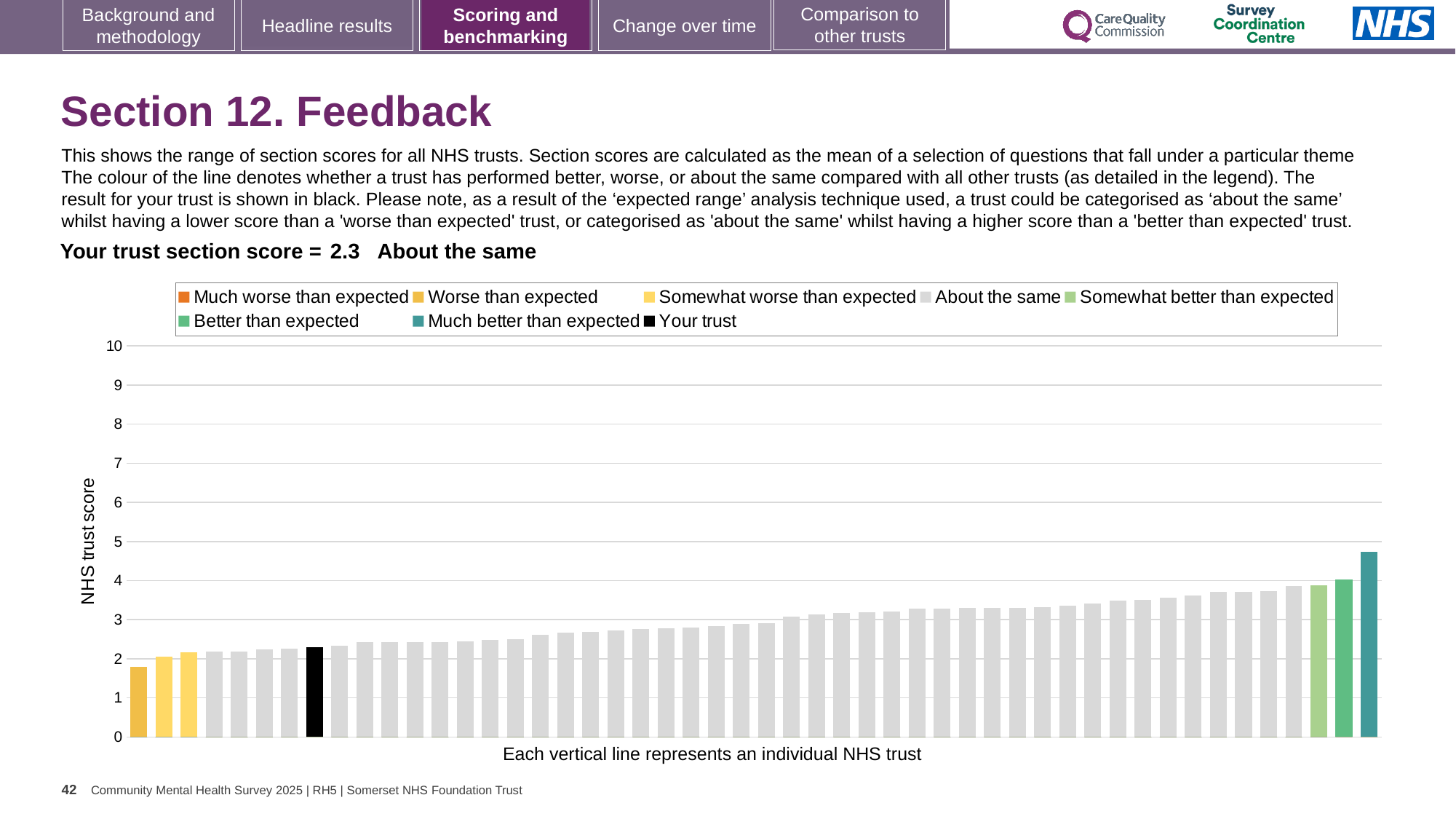
Which category is your trust's section score placed in? About the same How many bars are coloured as 'Much better than expected'? 1 What is the label on the y axis of the chart? NHS trust score Is the value of the tallest bar greater or less than 4? greater How many bars are coloured as 'Somewhat worse than expected'? 2 How many entries does the chart legend list? 8 Is the value of the shortest bar greater or less than 2? less What colour is the bar representing your trust? black What kind of chart is shown on the slide? bar chart What is the section score for your trust shown on the slide? 2.3 Is the value for your trust (the black bar) greater or less than 3? less Do the bar values rise or fall from left to right along the x axis? rise